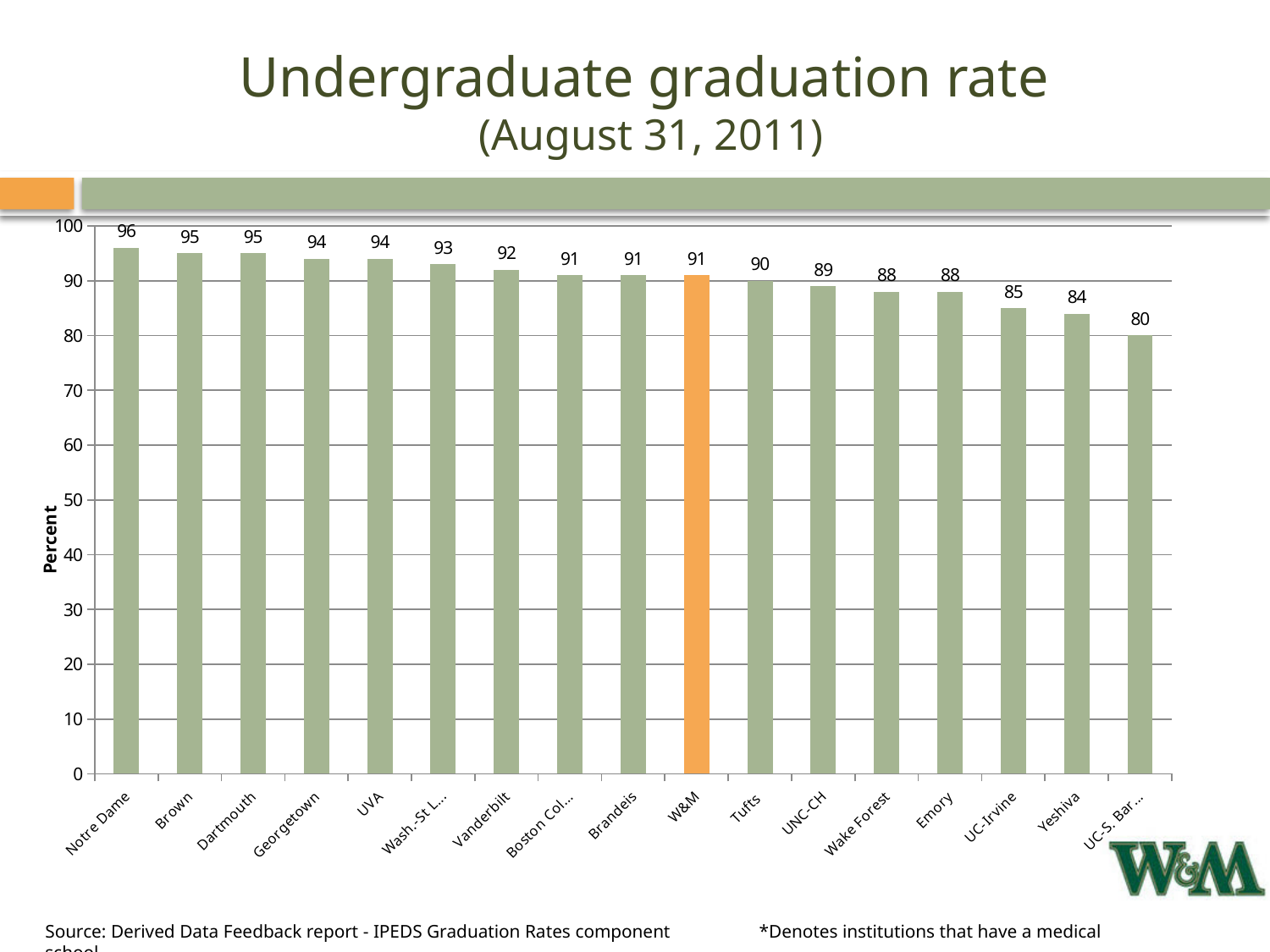
What type of chart is shown on the slide? Bar chart What is the undergraduate graduation rate for Notre Dame? 96 Which institution has the highest undergraduate graduation rate? Notre Dame Which bar is highlighted in orange rather than green? W&M What is the difference between the graduation rates of W&M and UC-Irvine? 6 What is the undergraduate graduation rate for W&M? 91 Which has a higher graduation rate, UNC-CH or Wake Forest? UNC-CH What is the undergraduate graduation rate for Emory? 88 Which has a higher graduation rate, Tufts or Vanderbilt? Vanderbilt Which institution has the lowest undergraduate graduation rate shown? UC-S. Bar... What is the difference between the graduation rates of Notre Dame and Yeshiva? 12 How many institutions are shown in the chart? 17